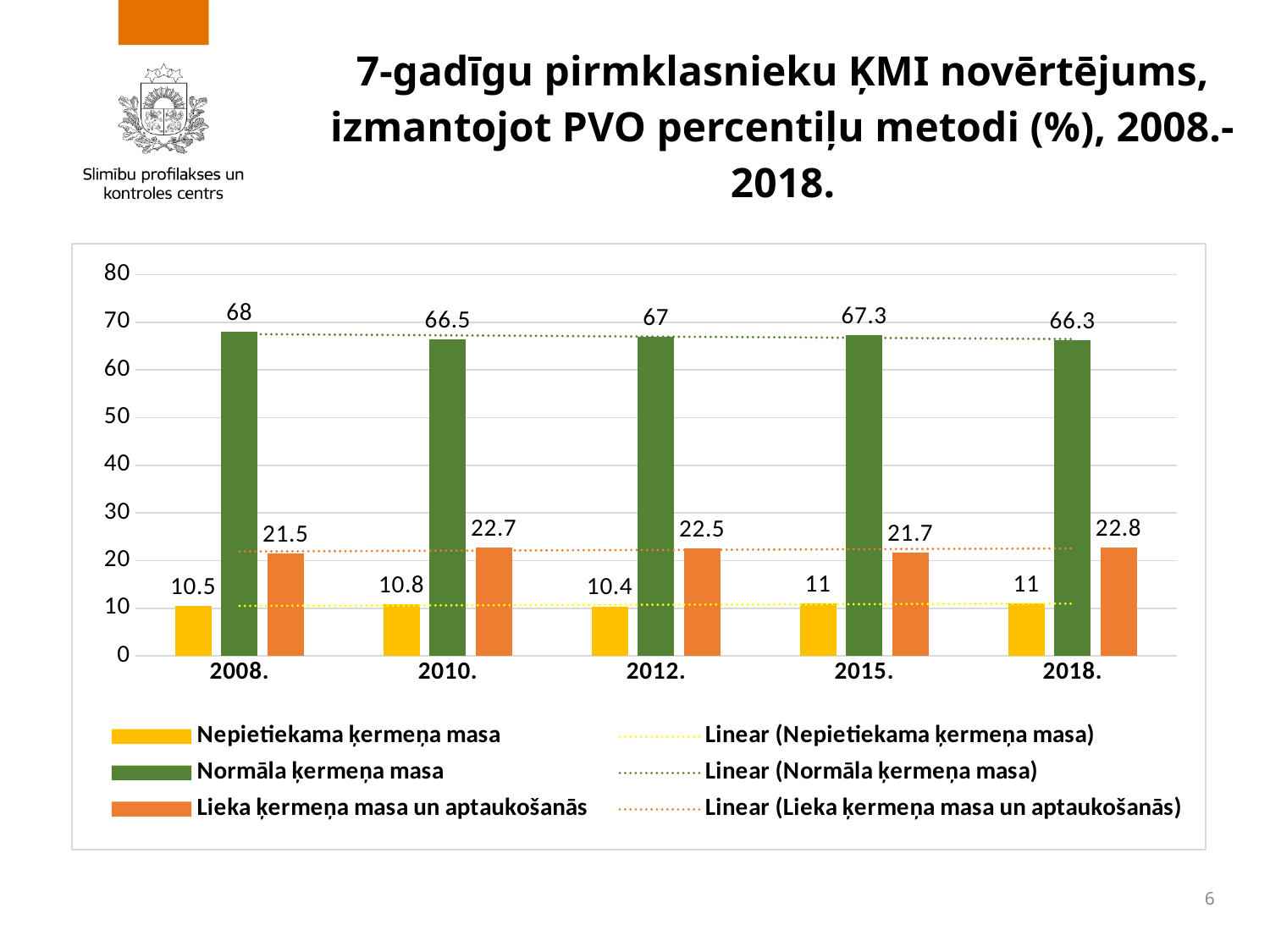
Which is larger in 2010.: Lieka ķermeņa masa un aptaukošanās or Nepietiekama ķermeņa masa? Lieka ķermeņa masa un aptaukošanās What is the value for Lieka ķermeņa masa un aptaukošanās in 2018.? 22.8 What is the difference between the Normāla ķermeņa masa values in 2008. and 2018.? 1.7 What colour are the bars for Normāla ķermeņa masa? green Is the value for Normāla ķermeņa masa in 2015. greater or less than 60? greater What kind of chart is shown on the slide? bar chart In which year is the value for Normāla ķermeņa masa highest? 2008. What is the value for Nepietiekama ķermeņa masa in 2012.? 10.4 How many entries does the legend list? 6 In which year is the value for Nepietiekama ķermeņa masa lowest? 2012. How many years are shown on the x axis? 5 What is the value for Normāla ķermeņa masa in 2008.? 68